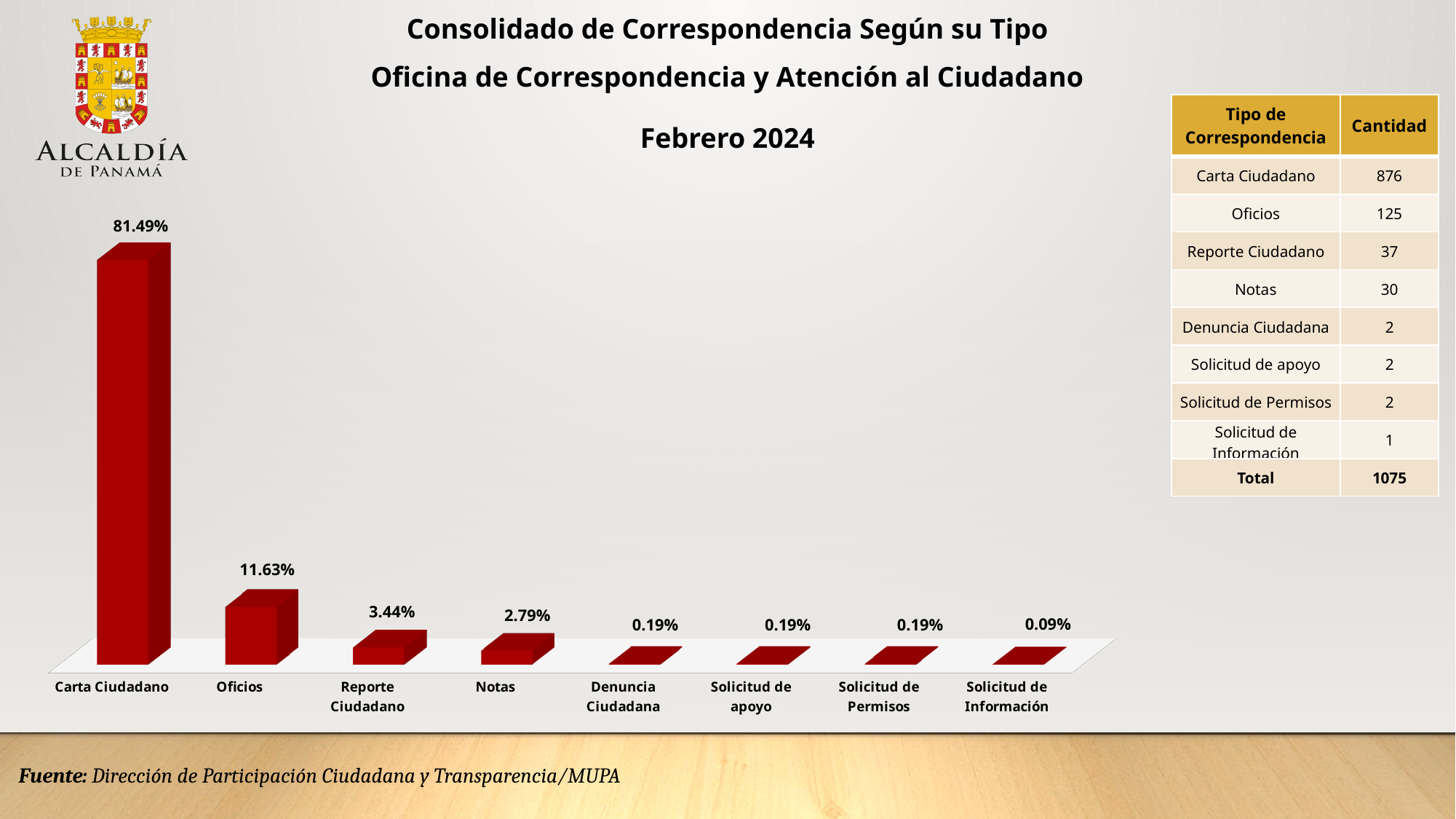
What percentage is shown for Carta Ciudadano in the chart? 81.49% What is the difference in percentage points between Reporte Ciudadano and Notas? 0.65 Do the values rise or fall from left to right along the x axis? Fall Which category has the highest percentage in the chart? Carta Ciudadano Which category has the lowest percentage in the chart? Solicitud de Información Which has a larger percentage, Reporte Ciudadano or Notas? Reporte Ciudadano What percentage is shown for Solicitud de Información in the chart? 0.09% What percentage is shown for Oficios in the chart? 11.63% What kind of chart is shown on the slide? Bar chart What percentage is shown for Notas in the chart? 2.79% How many categories are shown on the x axis of the chart? 8 What is the difference in percentage points between Carta Ciudadano and Oficios? 69.86